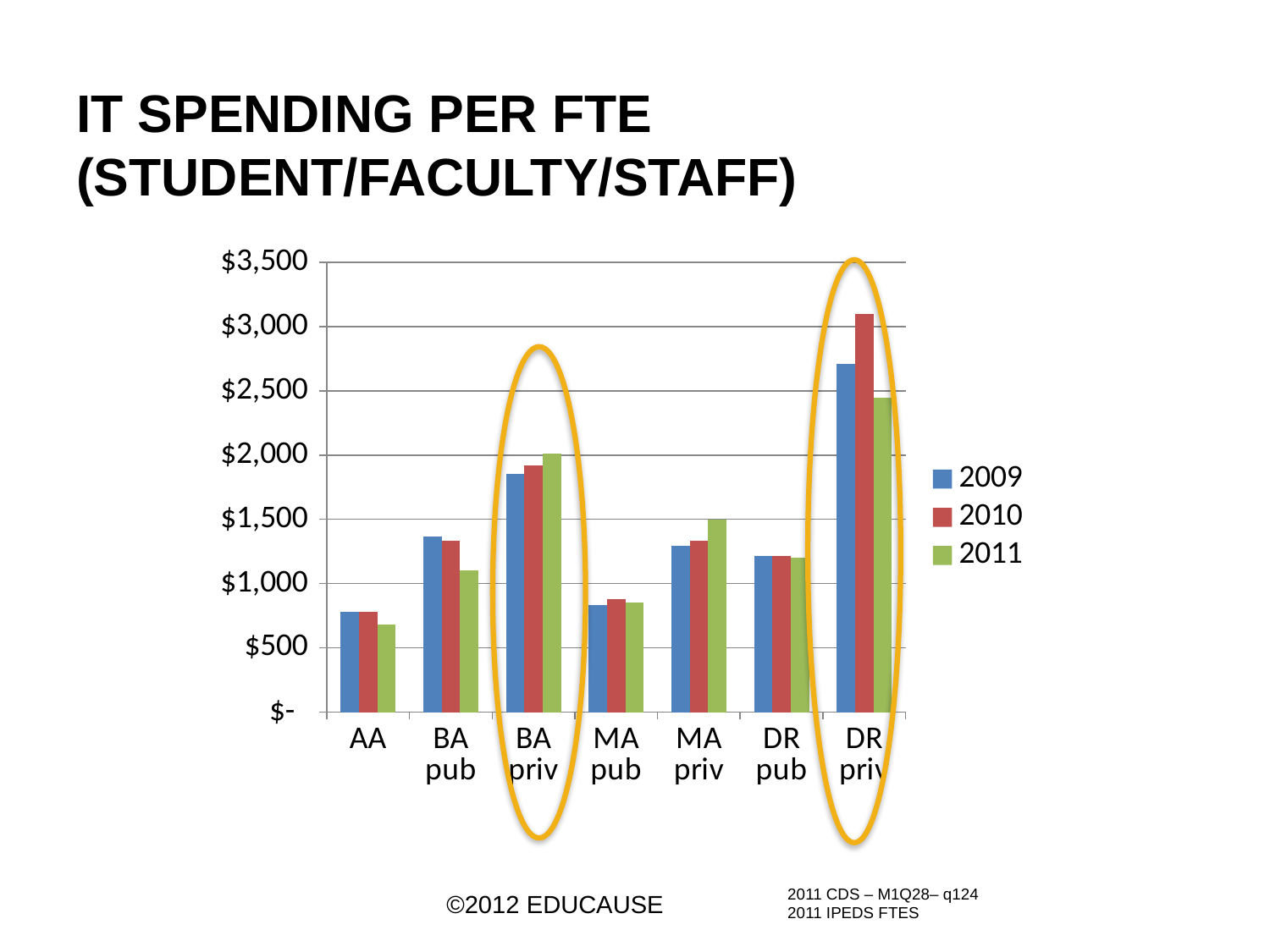
Which category has the highest IT spending per FTE in 2010? DR priv Is the 2009 value for DR priv greater or less than $2,500? greater How many series does the legend list? 3 Is the 2010 value for DR priv greater or less than $3,000? greater For BA priv, do the values rise or fall from 2009 to 2011? rise Which two categories are circled on the chart? BA priv and DR priv Which is larger in 2011, the value for BA priv or the value for MA priv? BA priv Is the 2011 value for AA greater or less than $1,000? less Which category has the lowest IT spending per FTE in 2011? AA What kind of chart is shown on the slide? bar chart How many categories are shown on the x axis of the chart? 7